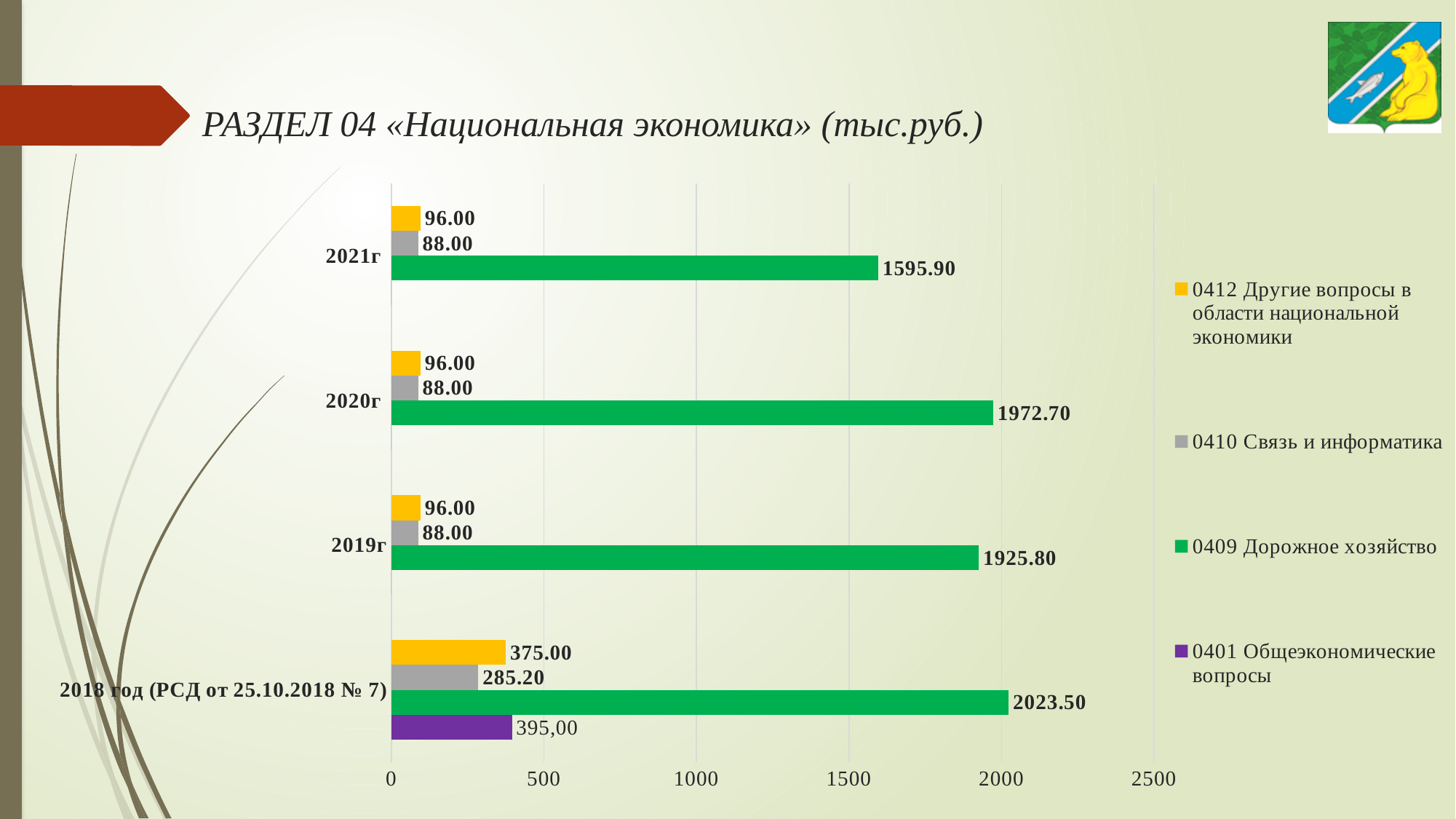
Which is larger: the 0409 Дорожное хозяйство value for 2019г or for 2020г? 2020г In which year is the value for 0409 Дорожное хозяйство the highest? 2018 год (РСД от 25.10.2018 № 7) In which year is the value for 0409 Дорожное хозяйство the lowest? 2021г What is the value for 0401 Общеэкономические вопросы in 2018 год (РСД от 25.10.2018 № 7)? 395,00 What kind of chart is shown on the slide? bar chart What colour are the bars for 0409 Дорожное хозяйство? green What is the difference between the 0409 Дорожное хозяйство values for 2020г and 2021г? 376.80 What is the value for 0409 Дорожное хозяйство in 2020г? 1972.70 What is the value for 0410 Связь и информатика in 2021г? 88.00 What is the value for 0412 Другие вопросы в области национальной экономики in 2018 год (РСД от 25.10.2018 № 7)? 375.00 Is the value for 0409 Дорожное хозяйство in 2021г greater or less than 2000? less How many series does the legend list? 4